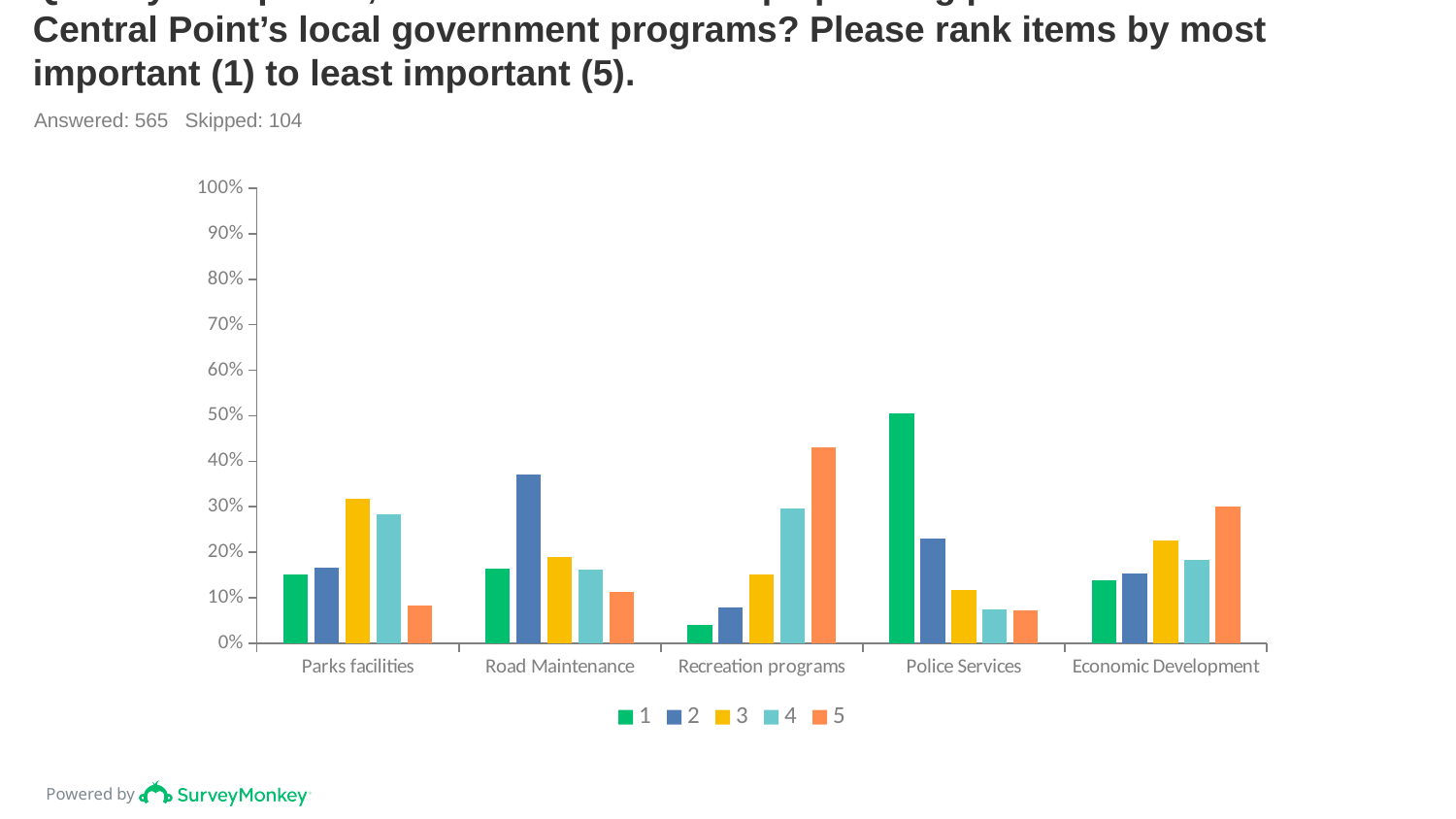
How many series does the chart's legend list? 5 What are the entries in the chart's legend? 1, 2, 3, 4, 5 Which category has the highest value for series 5 (least important)? Recreation programs Is the value for series 1 in Recreation programs greater or less than 10%? less For Parks facilities, which is larger: the value for series 3 or the value for series 5? series 3 How many program categories are shown on the x axis of the chart? 5 Which category has the highest value for series 1 (most important)? Police Services What kind of chart is shown on the slide? bar chart Is the value for series 1 in Police Services greater or less than 40%? greater Is the value for series 5 in Recreation programs greater or less than 40%? greater Which category has the lowest value for series 1 (most important)? Recreation programs